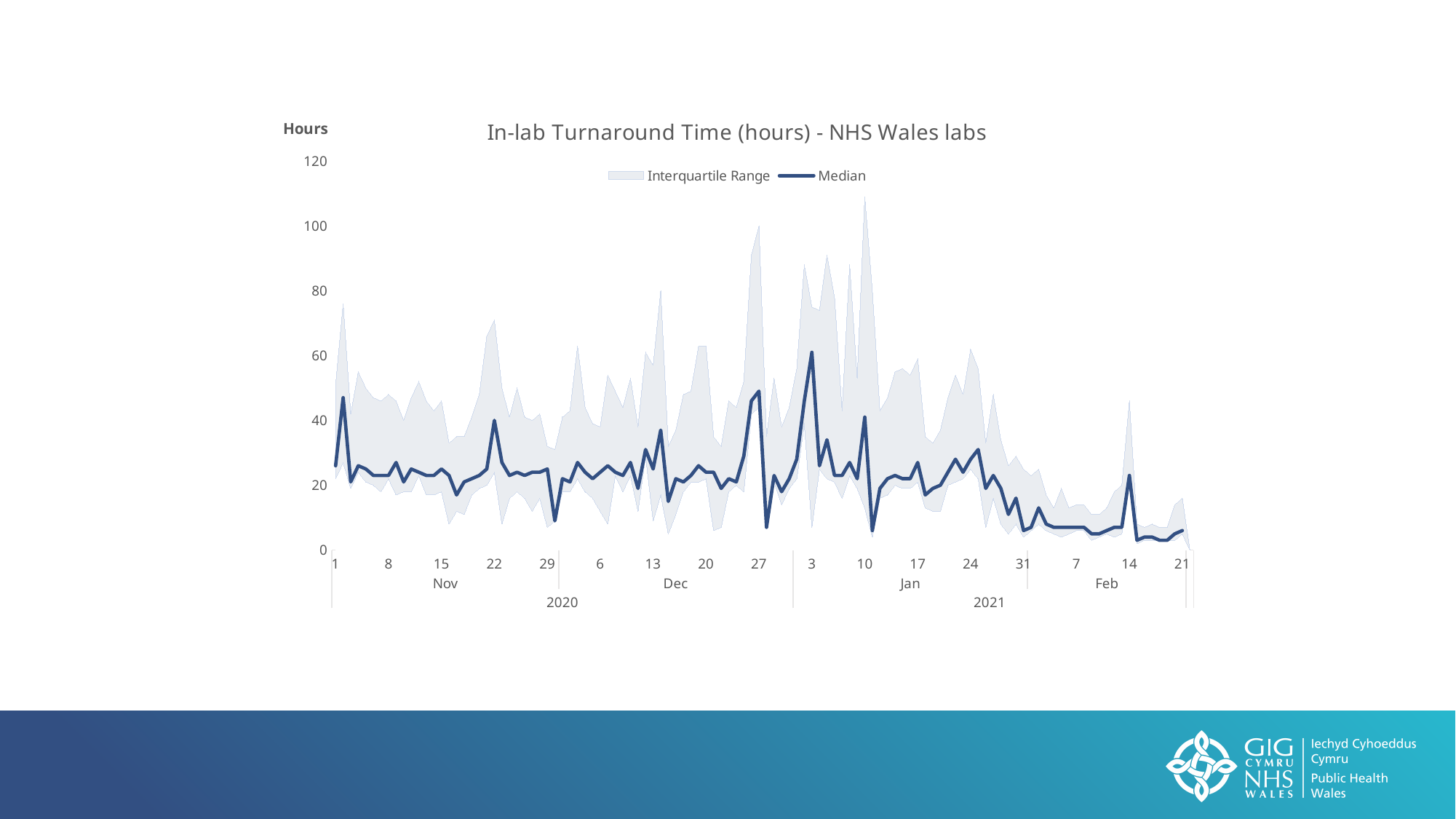
Which is larger, the Median value on 3 Jan 2021 or the Median value on 27 Dec 2020? 3 Jan 2021 How many series does the legend list? 2 Is the upper edge of the Interquartile Range around 10 Jan 2021 greater or less than 100? greater What are the two entries in the chart's legend? Interquartile Range and Median Does the Median value generally rise or fall from late January 2021 to late February 2021? fall Is the Median value on 27 Dec 2020 greater or less than 40? greater Which is larger, the Median value on 1 Nov 2020 or the Median value on 21 Feb 2021? 1 Nov 2020 What kind of chart is shown on the slide? combination area and line chart Around which date does the Median line reach its highest value? 3 Jan 2021 What is the title of the chart? In-lab Turnaround Time (hours) - NHS Wales labs Is the Median value on 21 Feb 2021 greater or less than 20? less